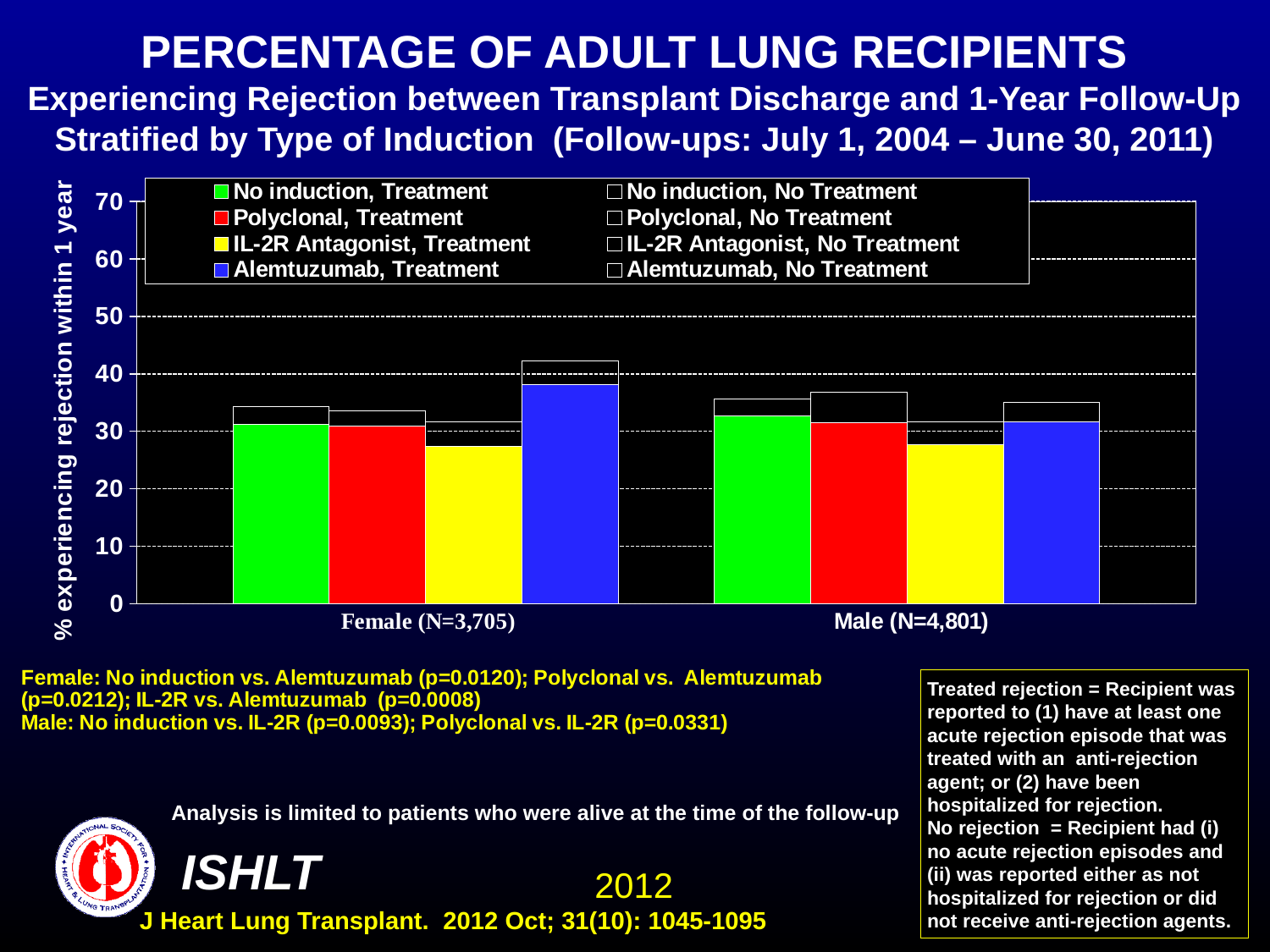
Is the 'IL-2R Antagonist, Treatment' value for the Male group greater or less than 30? less In the Female group, which induction type has the tallest stacked bar? Alemtuzumab How many groups are shown along the x axis? 2 In the Female group, which induction type has the shortest stacked bar? IL-2R Antagonist What kind of chart is shown on the slide? Stacked bar chart In the Female group, which is larger: the 'Alemtuzumab, Treatment' value or the 'No induction, Treatment' value? Alemtuzumab, Treatment What is the sample size (N) shown for the Female group on the x axis? N=3,705 Is the total stacked bar for Alemtuzumab in the Female group greater or less than 40? greater Is the 'Alemtuzumab, Treatment' value for the Female group greater or less than 30? greater In the Male group, which is larger: the 'No induction, Treatment' value or the 'IL-2R Antagonist, Treatment' value? No induction, Treatment In the Male group, which induction type has the shortest stacked bar? IL-2R Antagonist How many series does the legend list? 8